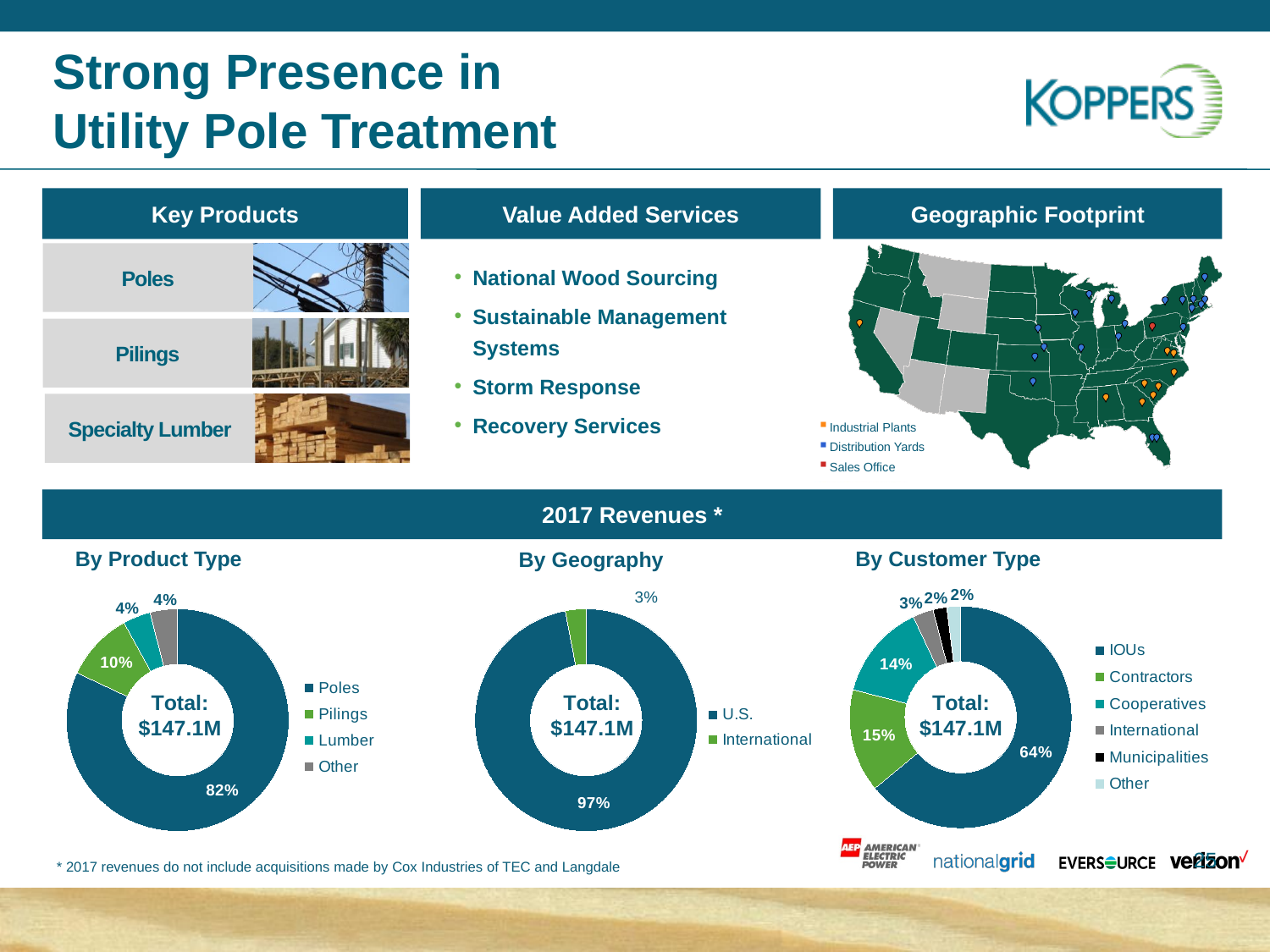
In the 'By Customer Type' chart, which is larger, Contractors or Cooperatives? Contractors What total revenue is shown in the centre of the 'By Geography' chart? $147.1M In the 'By Geography' chart, how many series does the legend list? 2 In the 'By Product Type' chart, what is the difference in percentage points between Poles and Pilings? 72 In the 'By Customer Type' chart, how many categories does the legend list? 6 In the 'By Product Type' chart, what share of revenue comes from Pilings? 10% In the 'By Product Type' chart, what share of revenue comes from Poles? 82% What kind of chart is the 'By Customer Type' chart? Pie (donut) chart In the 'By Customer Type' chart, what share of revenue comes from Cooperatives? 14% In the 'By Product Type' chart, which category has the largest share? Poles In the 'By Customer Type' chart, what share of revenue comes from IOUs? 64% In the 'By Geography' chart, what share of revenue is International? 3%